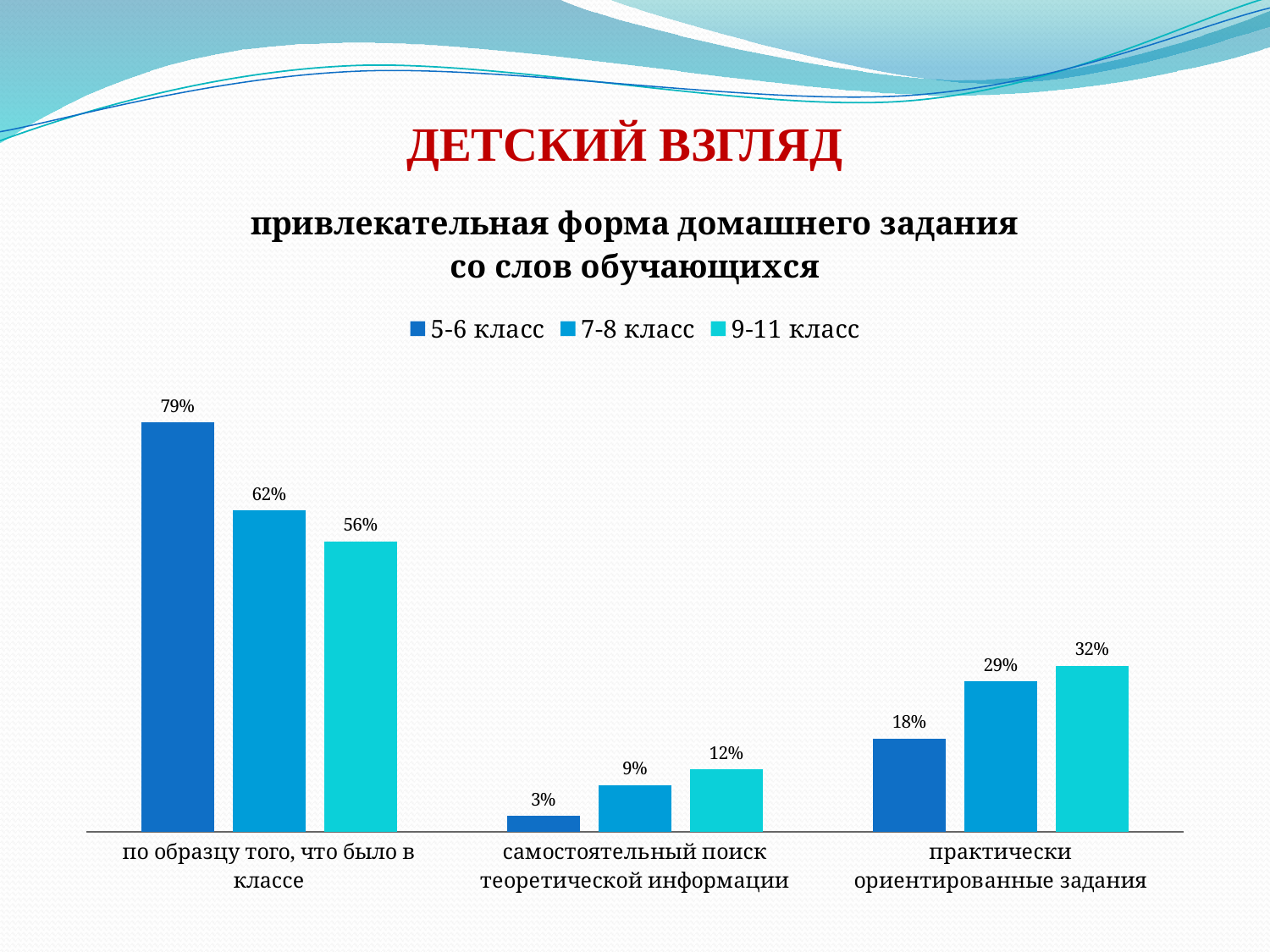
How many categories are shown on the x axis? 3 How many series does the legend list? 3 What kind of chart is shown on the slide? bar chart What is the title of the chart? привлекательная форма домашнего задания со слов обучающихся What is the value for 5-6 класс in the category 'по образцу того, что было в классе'? 79% Which category has the lowest value for 9-11 класс? самостоятельный поиск теоретической информации What is the value for 7-8 класс in the category 'самостоятельный поиск теоретической информации'? 9% Which is larger in the category 'практически ориентированные задания': the value for 7-8 класс or for 9-11 класс? 9-11 класс What is the value for 9-11 класс in the category 'практически ориентированные задания'? 32% What is the difference between the 5-6 класс and 9-11 класс values in the category 'по образцу того, что было в классе'? 23% What is the difference between the 9-11 класс and 5-6 класс values in the category 'практически ориентированные задания'? 14% Which category has the highest value for 5-6 класс? по образцу того, что было в классе